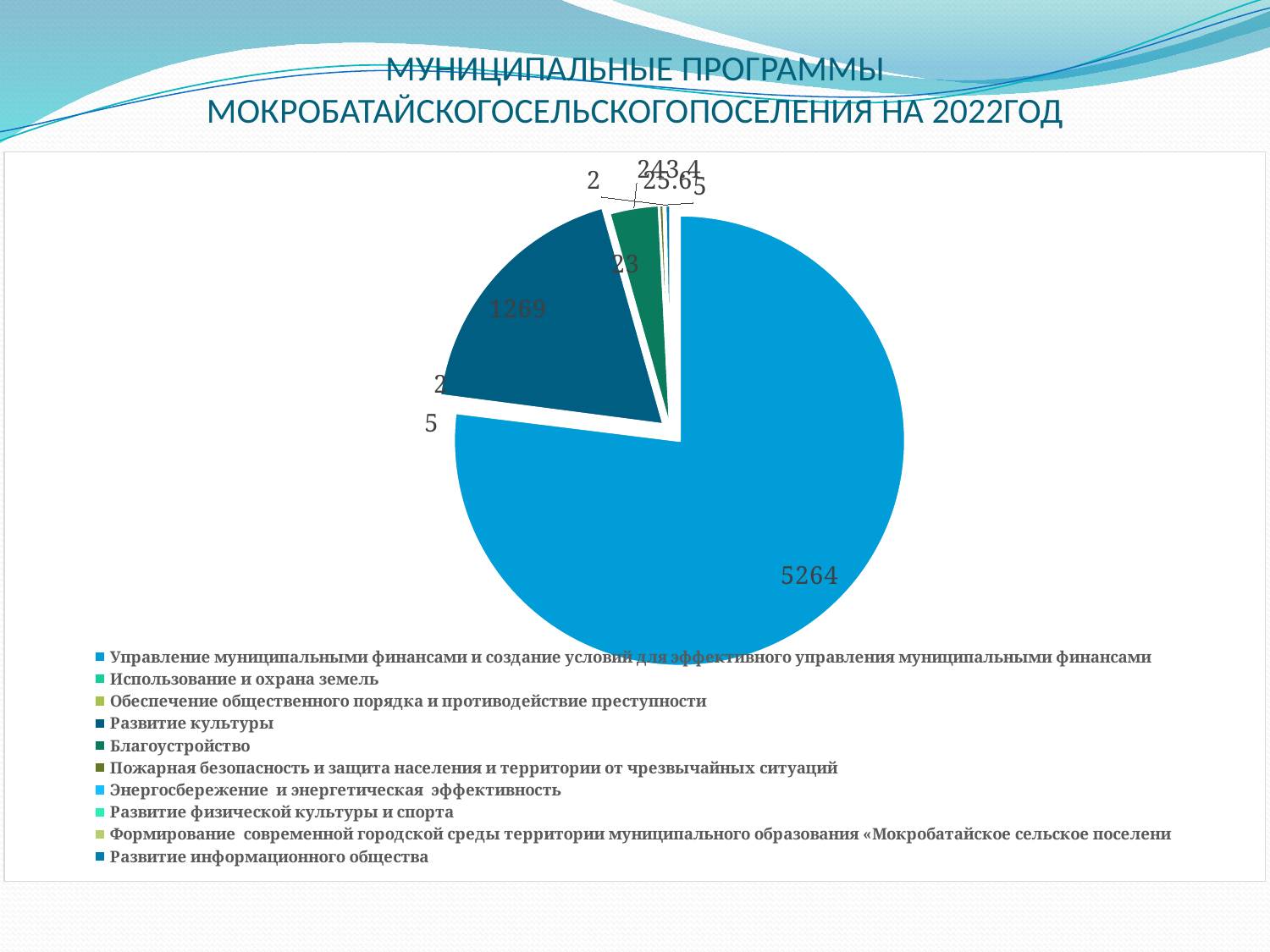
How many entries does the legend of the pie chart list? 10 What is the difference between the largest slice (5264) and the slice for "Развитие культуры" (1269)? 3995 What is the difference between the slice for "Развитие культуры" and the slice for "Благоустройство"? 1025.6 Which program has the largest slice in the pie chart? Управление муниципальными финансами и создание условий для эффективного управления муниципальными финансами What kind of chart is shown on the slide? pie chart Which legend entry is listed last in the pie chart's legend? Развитие информационного общества What is the value shown for "Благоустройство" in the pie chart? 243.4 What is the value shown for "Развитие культуры" in the pie chart? 1269 Which is larger in the pie chart: the slice for "Развитие культуры" or the slice for "Благоустройство"? Развитие культуры Which year does the slide title say the municipal programs are for? 2022 What is the value of the largest slice of the pie chart? 5264